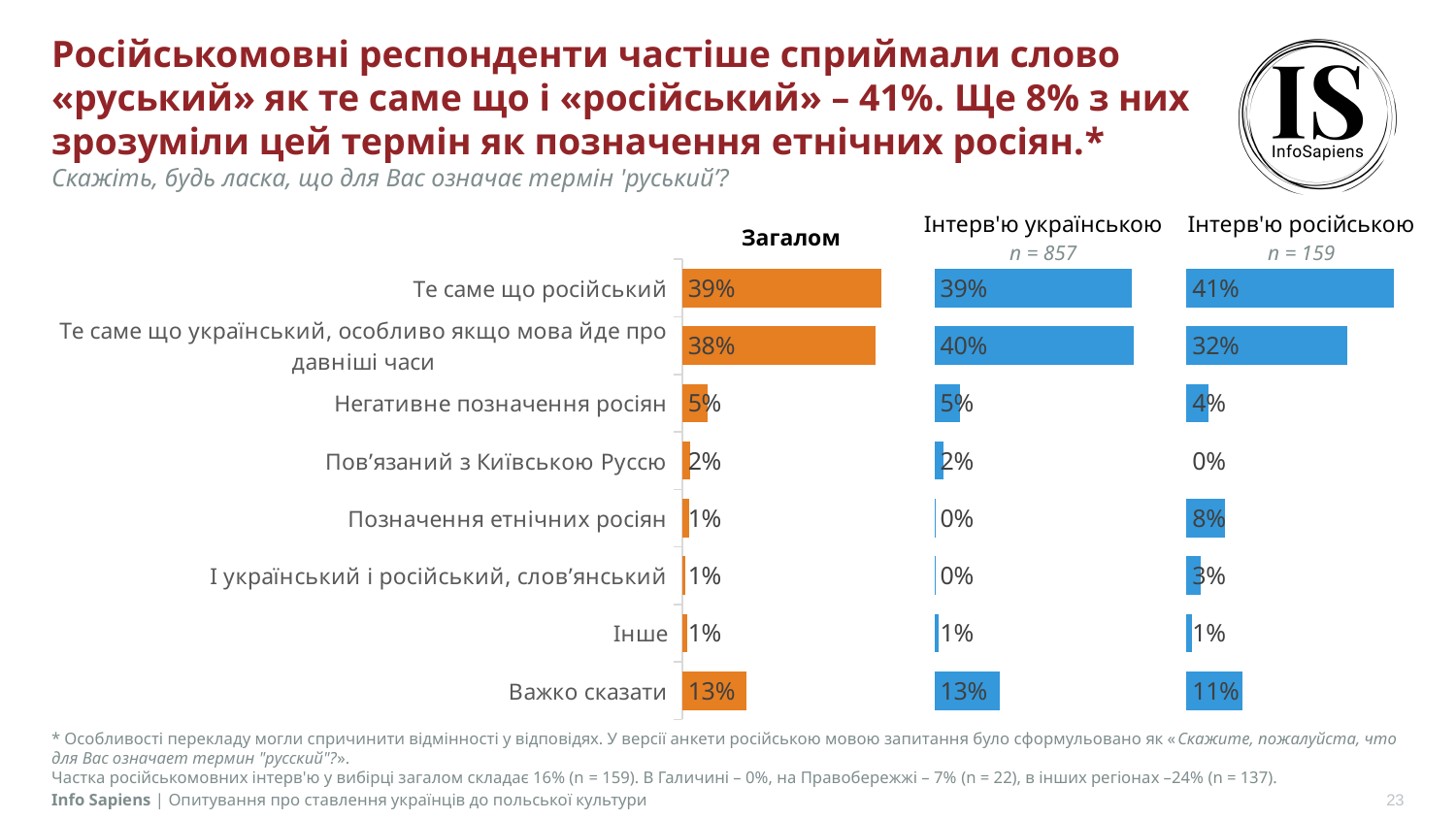
In the "Загалом" chart, what is the difference between "Важко сказати" and "Негативне позначення росіян"? 8 percentage points In the "Інтерв'ю російською" chart, which category has the lowest value? Пов’язаний з Київською Руссю In the "Інтерв'ю російською" chart, what is the value for "Позначення етнічних росіян"? 8% In the "Інтерв'ю українською" chart, which category has the highest value? Те саме що український, особливо якщо мова йде про давніші часи What type of chart is used on this slide? Bar chart In the "Інтерв'ю російською" chart, what is the difference between "Те саме що російський" and "Те саме що український, особливо якщо мова йде про давніші часи"? 9 percentage points What is the sample size (n) shown for the "Інтерв'ю російською" chart? n = 159 How many categories are shown in the "Загалом" chart? 8 In the "Інтерв'ю українською" chart, what is the value for "Те саме що український, особливо якщо мова йде про давніші часи"? 40% In the "Інтерв'ю російською" chart, which category has the highest value? Те саме що російський Which is larger: "Важко сказати" in the "Інтерв'ю українською" chart or "Важко сказати" in the "Інтерв'ю російською" chart? Інтерв'ю українською In the "Загалом" chart, what is the value for "Те саме що російський"? 39%